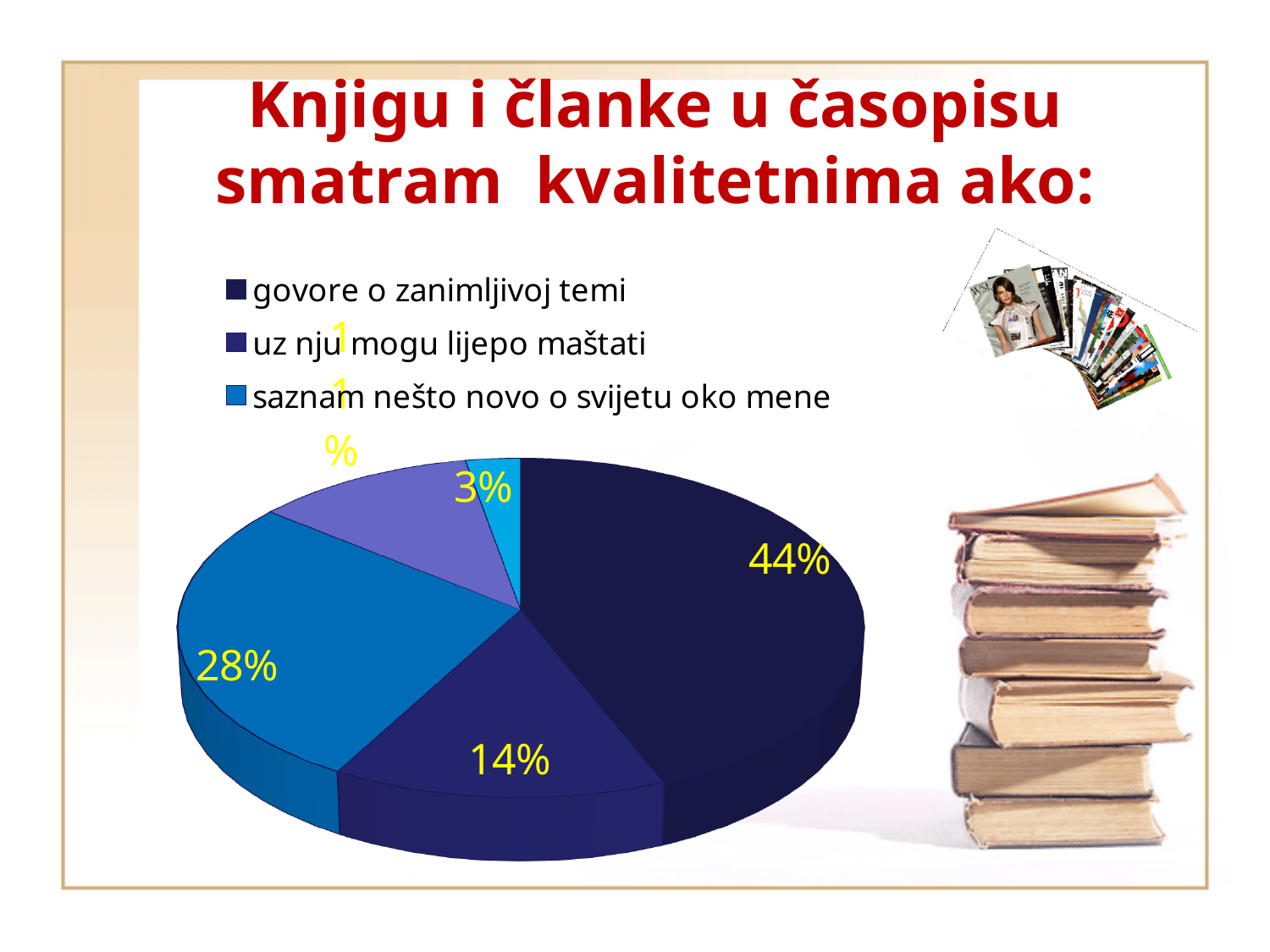
What is the smallest percentage labelled on the pie chart? 3% Which slice is larger: "saznam nešto novo o svijetu oko mene" or "uz nju mogu lijepo maštati"? saznam nešto novo o svijetu oko mene How many slices does the pie chart have? 5 What percentage of the pie corresponds to "govore o zanimljivoj temi"? 44% What percentage of the pie corresponds to "uz nju mogu lijepo maštati"? 14% What kind of chart is shown on the slide? pie chart What percentage of the pie corresponds to "saznam nešto novo o svijetu oko mene"? 28% How many entries does the chart legend list? 3 What is the title of the slide containing the pie chart? Knjigu i članke u časopisu smatram kvalitetnima ako: By how many percentage points does "govore o zanimljivoj temi" exceed "saznam nešto novo o svijetu oko mene"? 16 percentage points By how many percentage points does "saznam nešto novo o svijetu oko mene" exceed "uz nju mogu lijepo maštati"? 14 percentage points Which legend category has the largest slice of the pie? govore o zanimljivoj temi